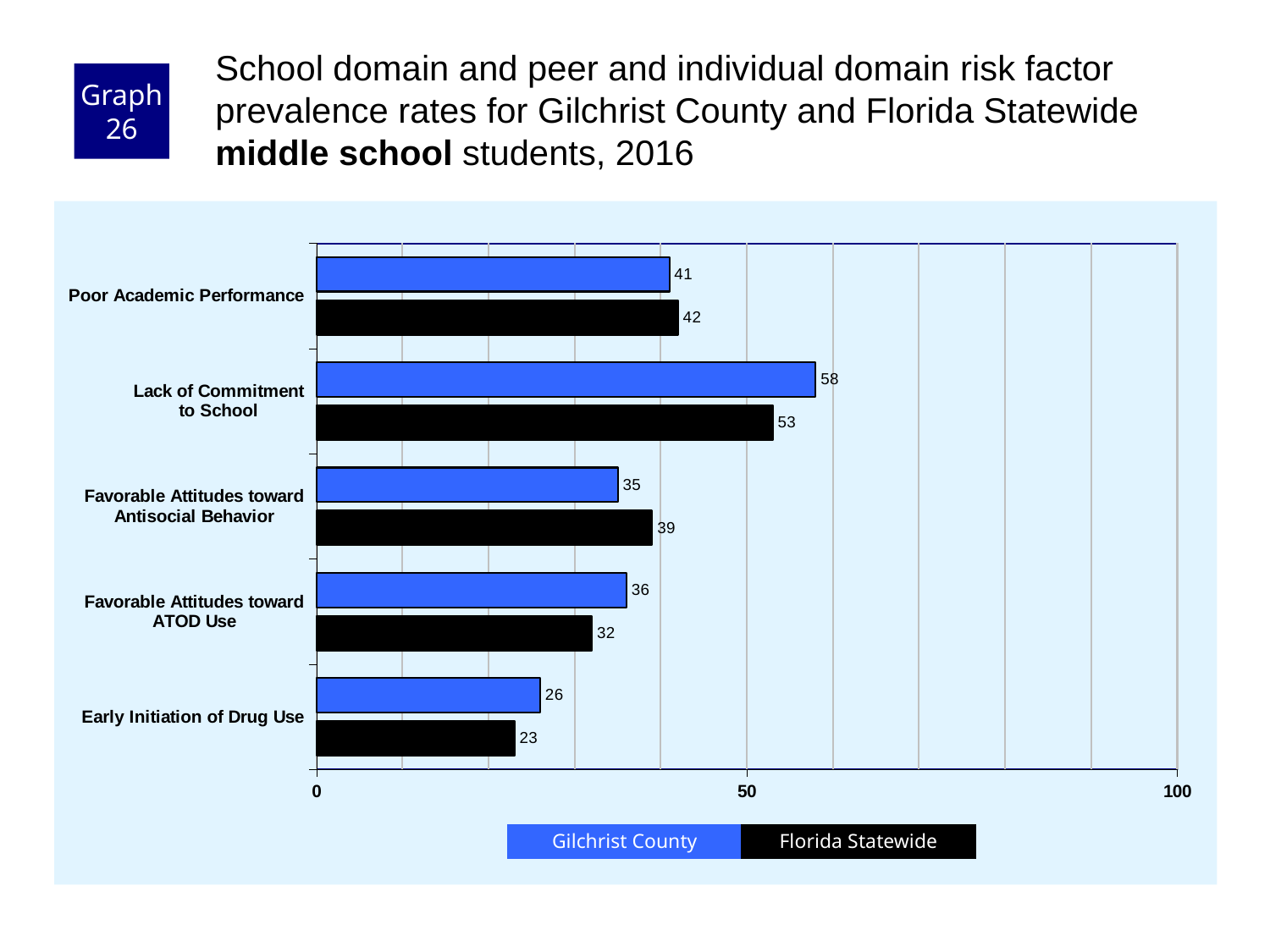
What is the Florida Statewide value for Favorable Attitudes toward Antisocial Behavior? 39 Which risk factor has the lowest Florida Statewide value? Early Initiation of Drug Use Is the Gilchrist County value for Poor Academic Performance greater or less than 50? less What kind of chart is shown on the slide? bar chart What is the difference between the Gilchrist County and Florida Statewide values for Lack of Commitment to School? 5 For Favorable Attitudes toward ATOD Use, which is larger: the Gilchrist County value or the Florida Statewide value? Gilchrist County What is the Gilchrist County value for Lack of Commitment to School? 58 How many risk factor categories are shown on the chart? 5 Which risk factor has the highest Gilchrist County value? Lack of Commitment to School Which colour represents Florida Statewide in the chart? black What is the Florida Statewide value for Early Initiation of Drug Use? 23 How many series does the legend list? 2